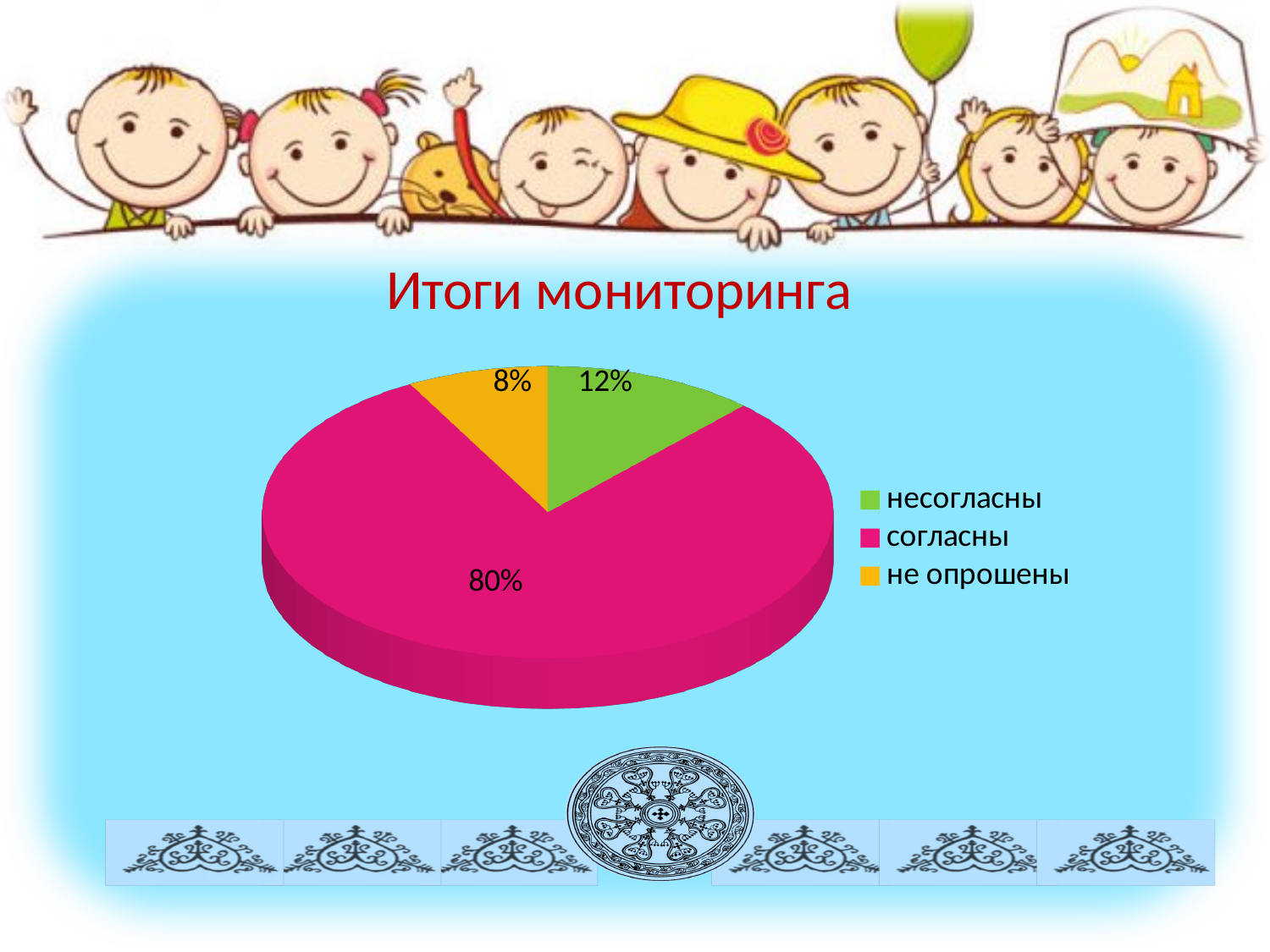
What share of the pie does the "согласны" slice represent? 80% Which is larger, the value for "несогласны" or the value for "не опрошены"? несогласны What is the title of the chart? Итоги мониторинга What is the value shown for "несогласны"? 12% What is the value shown for "не опрошены"? 8% What is the difference between the "согласны" and "несогласны" values? 68% Which category has the largest slice of the pie? согласны Which category has the smallest slice of the pie? не опрошены What kind of chart is shown on the slide? pie chart What is the difference between the "несогласны" and "не опрошены" values? 4% What colour is the "не опрошены" slice? orange How many categories does the pie chart show? 3